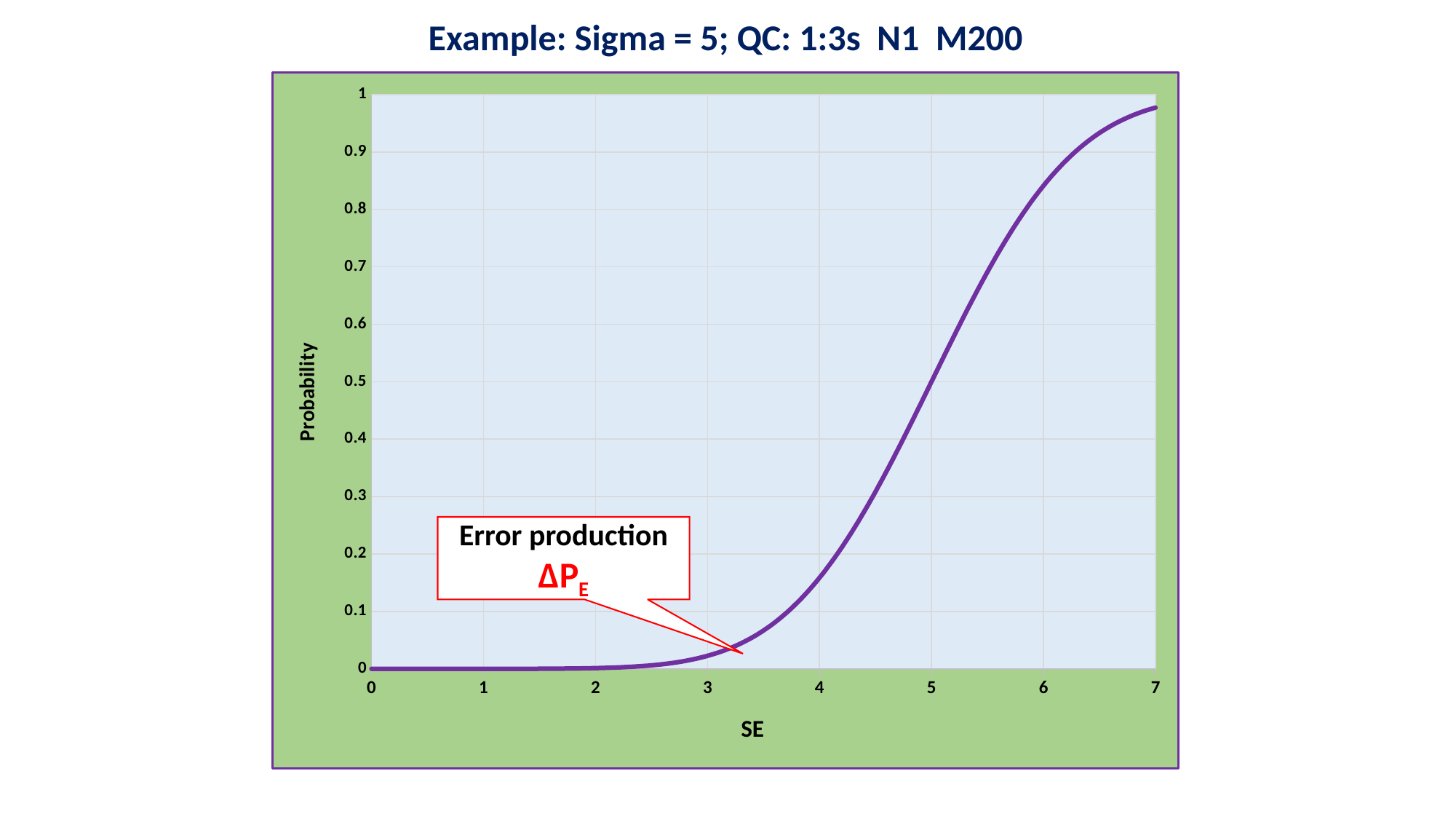
Is the probability at SE = 7 greater or less than 0.9? greater Which has the higher probability on the curve, SE = 4 or SE = 6? SE = 6 Is the probability at SE = 6 greater or less than 0.7? greater How many curves are plotted on the chart? 1 Is the probability at SE = 4 greater or less than 0.3? less What is the label of the x axis? SE What kind of chart is shown on the slide? Line chart What is the title of the slide's chart? Example: Sigma = 5; QC: 1:3s N1 M200 What is the maximum value shown on the Probability axis? 1 Does the plotted probability rise or fall as SE increases from 0 to 7? Rises